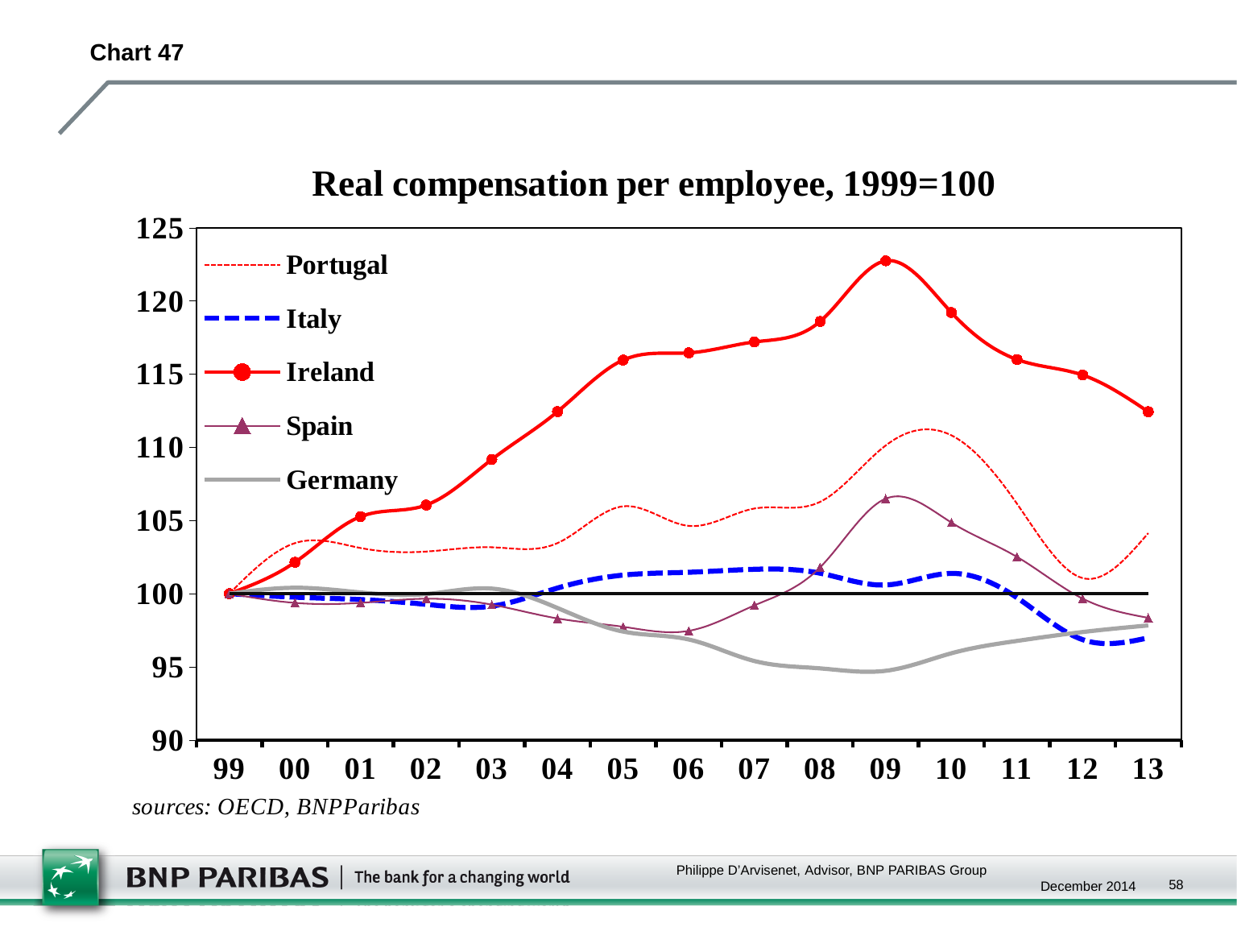
Is the value for Germany in 09 greater or less than 100? less How many years are shown along the x axis? 15 How many series does the legend list? 5 Is the value for Italy in 12 greater or less than 100? less Is the value for Spain in 09 greater or less than 105? greater Which series is drawn with triangle markers? Spain Does the Ireland series rise or fall from 99 to 09? rise What kind of chart is shown on the slide? line chart Which country has the highest real compensation per employee index in 09? Ireland Which country has the lowest value in 08? Germany Which country has the lowest real compensation per employee index in 09? Germany